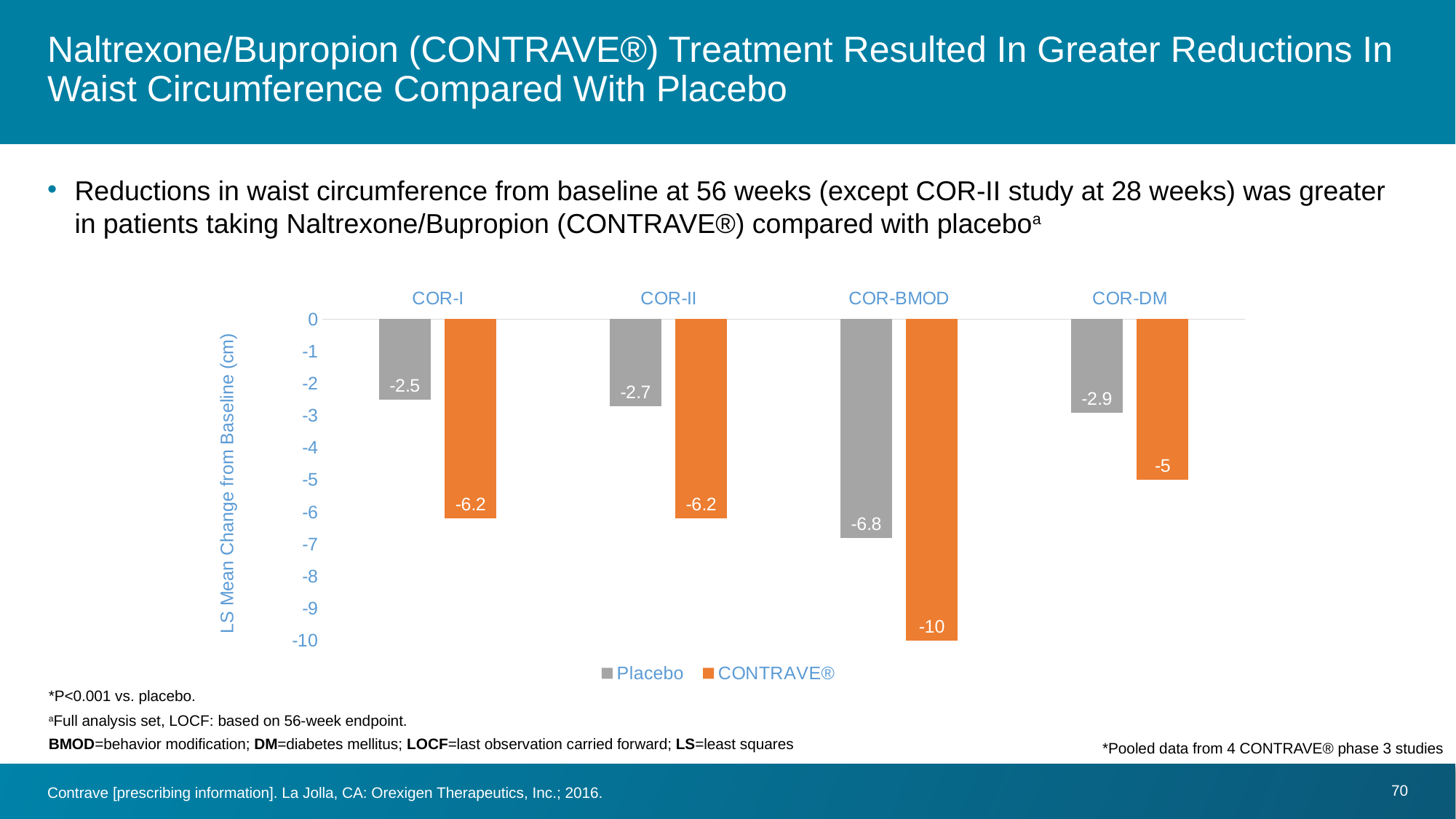
What is the LS mean change from baseline for Placebo in the COR-BMOD study? -6.8 What is the label of the vertical axis of the chart? LS Mean Change from Baseline (cm) How many series does the chart legend list? 2 What is the LS mean change from baseline for Placebo in the COR-I study? -2.5 Which has a larger reduction in waist circumference in the COR-DM study, Placebo or CONTRAVE®? CONTRAVE® How many studies are shown on the x axis of the chart? 4 What kind of chart is shown on the slide? Bar chart What is the LS mean change from baseline in waist circumference for CONTRAVE® in the COR-BMOD study? -10 In which study does CONTRAVE® show the smallest reduction in waist circumference? COR-DM What is the difference between the CONTRAVE® and Placebo values in the COR-II study? 3.5 In which study does CONTRAVE® show the largest reduction in waist circumference? COR-BMOD What is the LS mean change from baseline for CONTRAVE® in the COR-DM study? -5